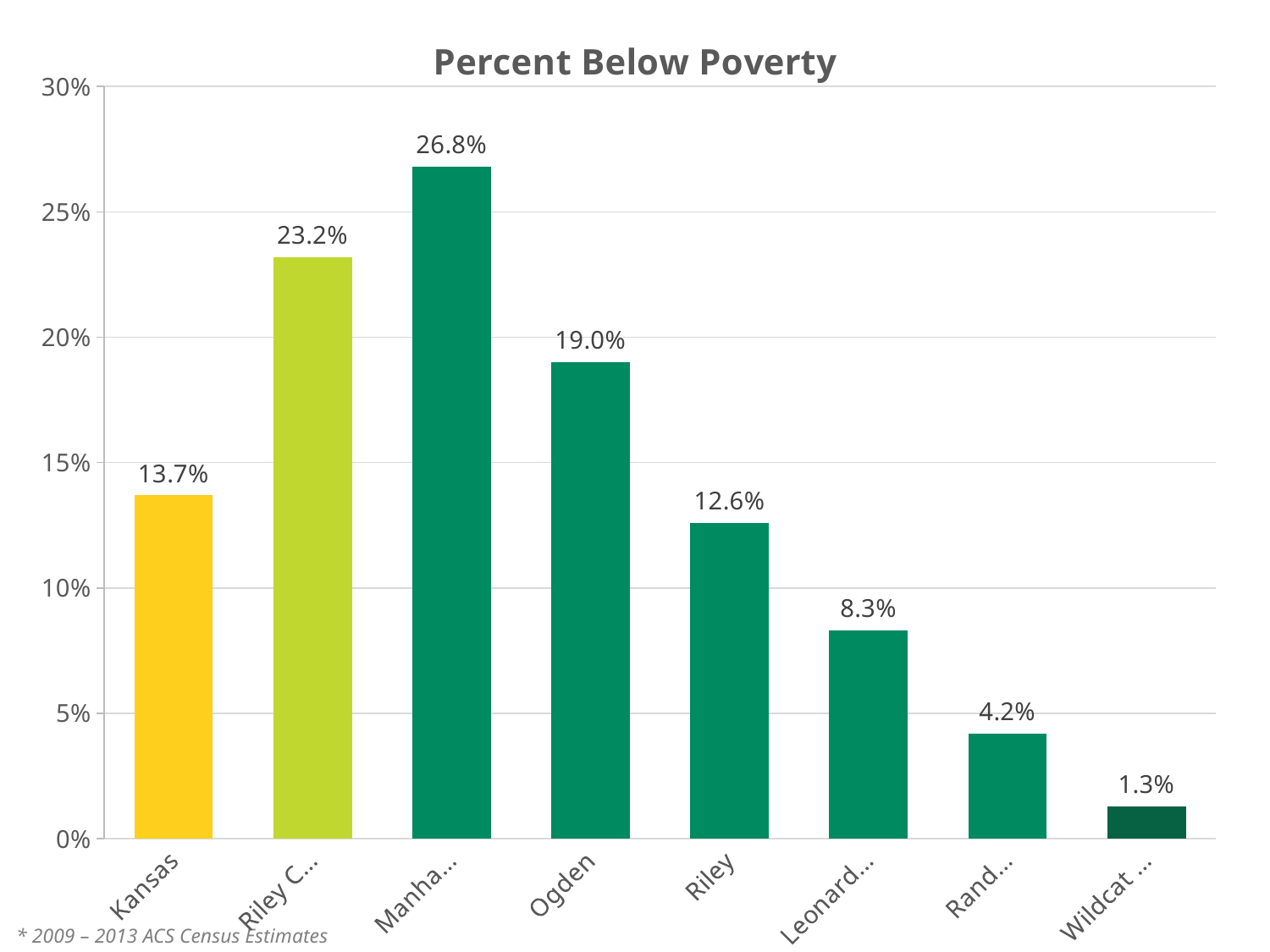
What is the value of the second bar from the left (labelled "Riley C...")? 23.2% What is the value for Ogden? 19.0% What is the difference between the values for Ogden and Riley? 6.4% What is the lowest value shown on the chart? 1.3% What is the value for Riley? 12.6% What is the title of the chart? Percent Below Poverty What kind of chart is shown on the slide? bar chart Is the value for Kansas greater or less than 15%? less Which is larger, the value for Kansas or the value for Ogden? Ogden How many bars are shown on the chart? 8 What is the highest value shown on the chart? 26.8% What is the value for Kansas? 13.7%